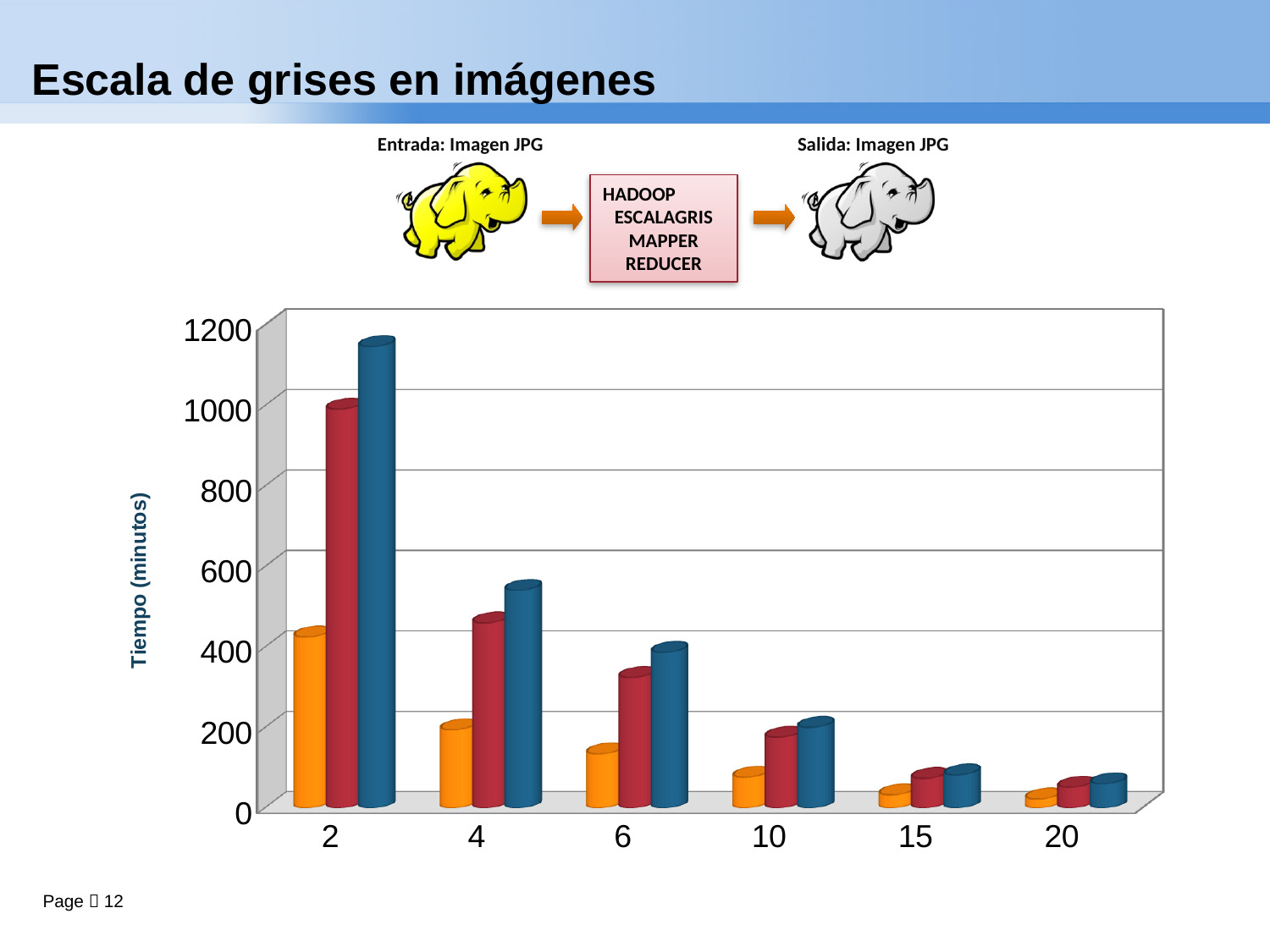
Do the bar values rise or fall as you move from category 2 to category 20 along the x axis? fall Is the value of the orange bar for category 2 greater or less than 600? less Is the value of the blue bar for category 10 greater or less than 400? less Which category on the x axis has the shortest bars? 20 Is the value of the blue bar for category 2 greater or less than 1000? greater What is the title of the vertical axis of the chart? Tiempo (minutos) How many categories are shown on the x axis of the chart? 6 Which category on the x axis has the tallest bars? 2 How many bars are plotted for each category on the chart? 3 Which is larger for category 6: the orange bar or the blue bar? the blue bar What kind of chart is shown on the slide? bar chart